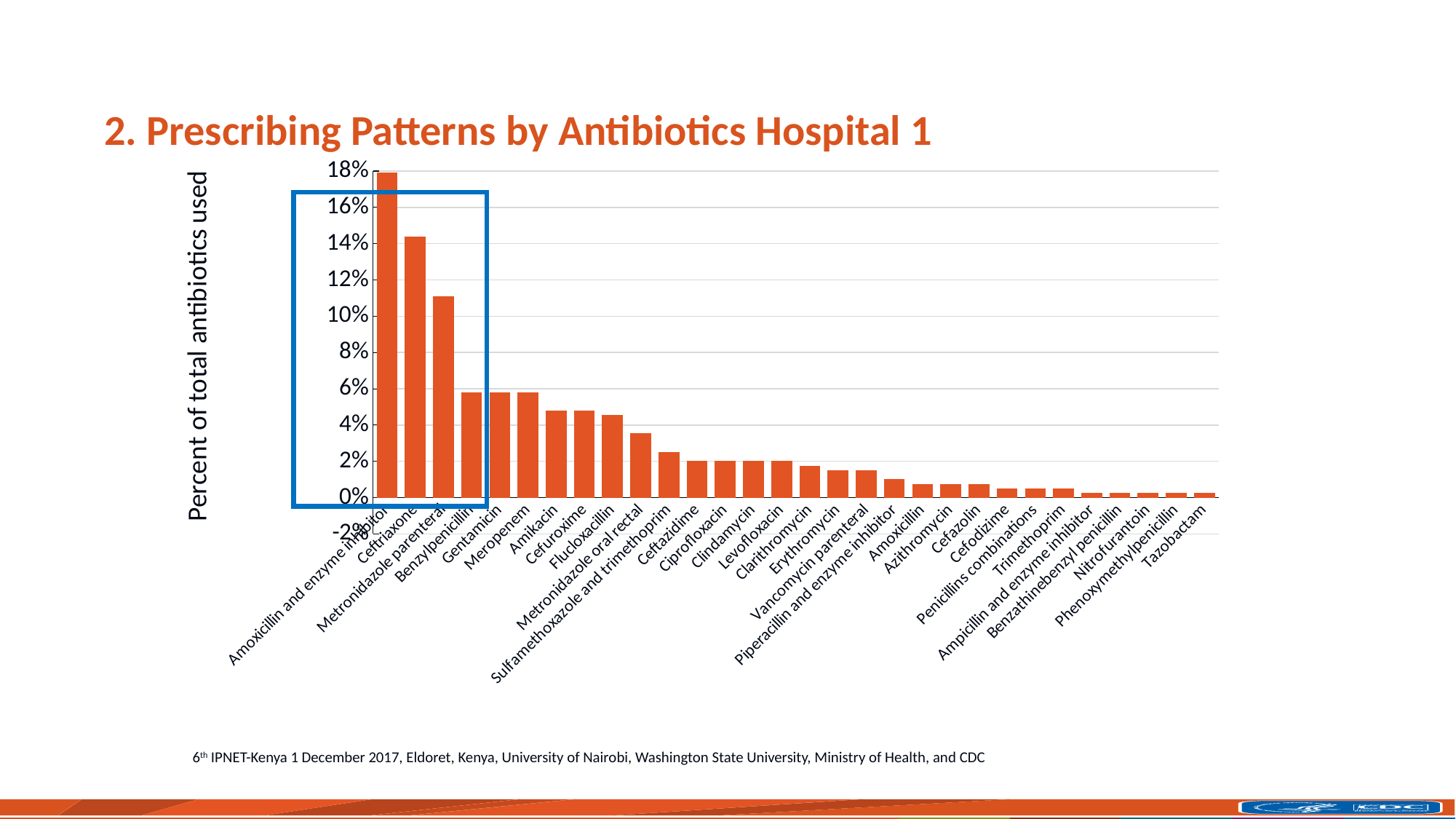
Which is larger, the value for Gentamicin or the value for Amikacin? Gentamicin What is the label on the vertical axis of the chart? Percent of total antibiotics used Which is larger, the value for Ceftriaxone or the value for Metronidazole parenteral? Ceftriaxone Is the value for Amoxicillin and enzyme inhibitor greater or less than 16%? greater Which antibiotic has the highest percent of total antibiotics used? Amoxicillin and enzyme inhibitor Is the value for Benzylpenicillin greater or less than 4%? greater How many antibiotics are plotted on the x axis? 30 Do the values rise or fall moving from left to right along the x axis? fall Is the value for Ceftriaxone greater or less than 12%? greater What kind of chart is shown on the slide? bar chart